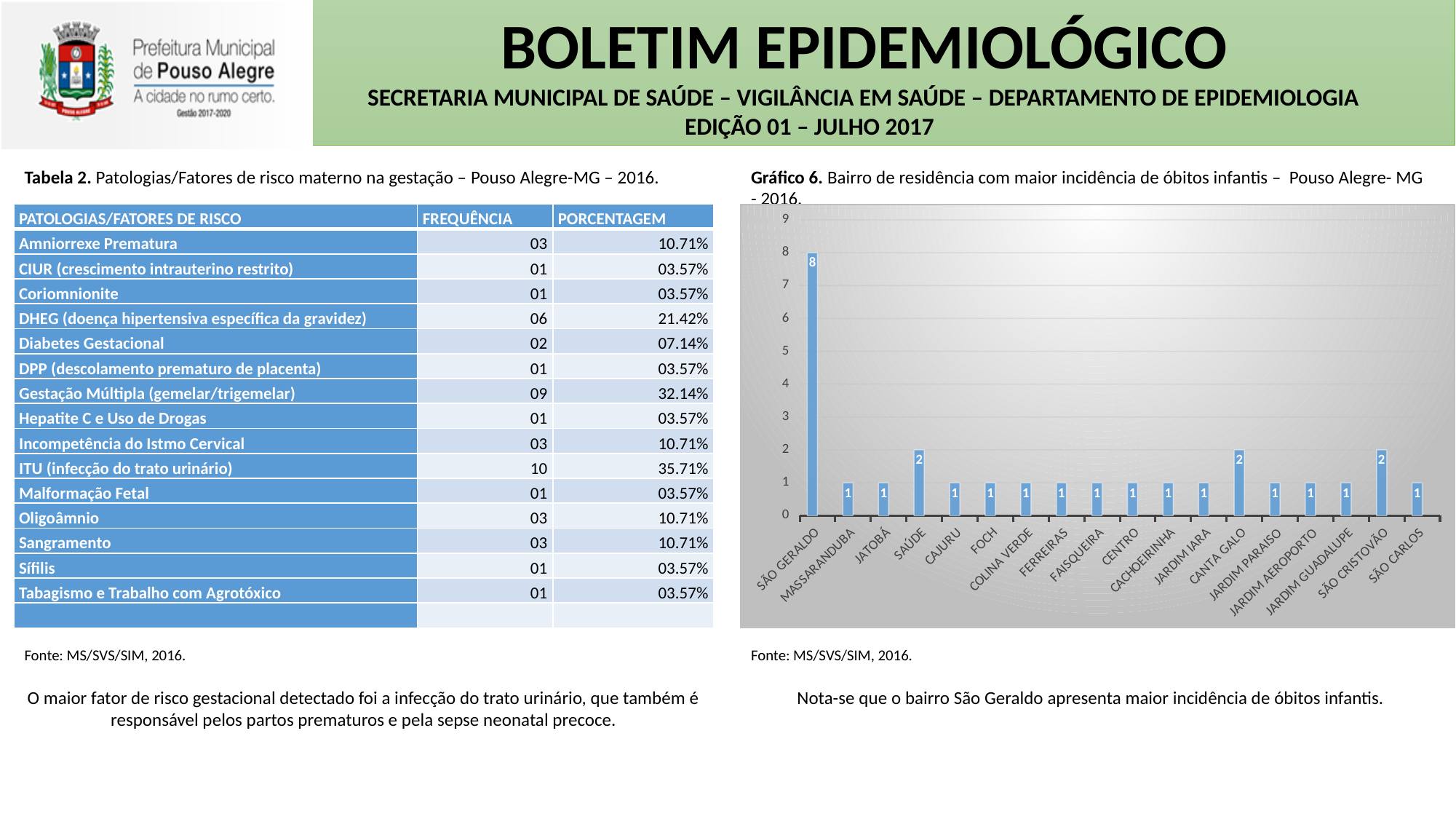
In Gráfico 6, what is the value for SÃO CRISTOVÃO? 2 What is the highest value shown on the vertical axis of Gráfico 6? 9 What type of chart is Gráfico 6? bar chart In Gráfico 6, which has a larger value, SAÚDE or JATOBÁ? SAÚDE In Gráfico 6, how many bairros have a value of 2? 3 In Gráfico 6, what is the value for CANTA GALO? 2 In Gráfico 6, what is the value for SÃO GERALDO? 8 In Gráfico 6, is the value for SÃO GERALDO greater or less than 5? greater In Gráfico 6, what is the value for CENTRO? 1 In Gráfico 6, what is the difference between the values for SÃO GERALDO and SAÚDE? 6 How many bairros are shown in Gráfico 6? 18 In Gráfico 6, which bairro has the highest value? SÃO GERALDO